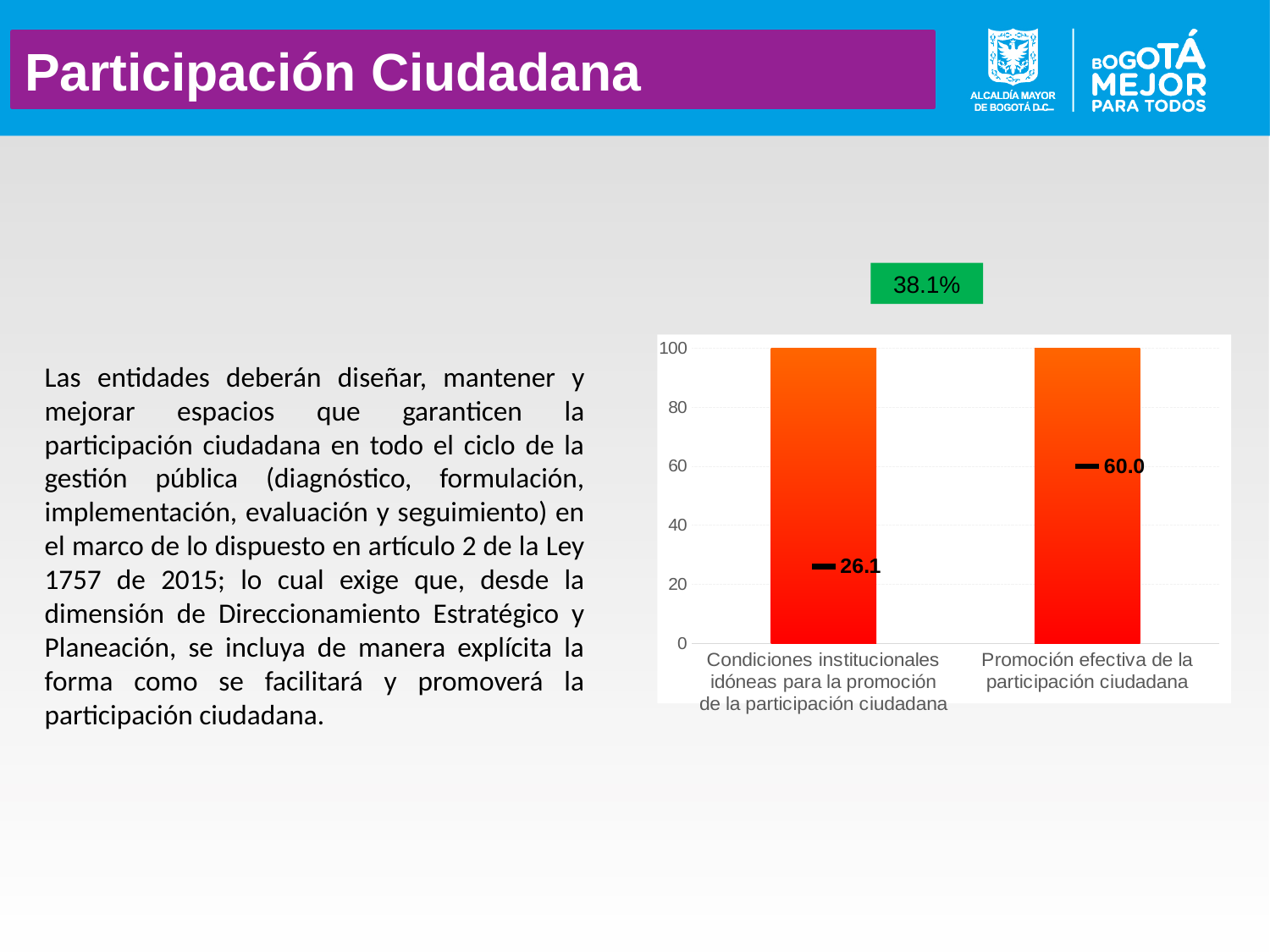
Is the marked value for "Promoción efectiva de la participación ciudadana" larger or smaller than the one for "Condiciones institucionales idóneas para la promoción de la participación ciudadana"? larger What is the difference between the marked values for "Promoción efectiva de la participación ciudadana" and "Condiciones institucionales idóneas para la promoción de la participación ciudadana"? 33.9 How many categories are shown on the x axis of the chart? 2 Which category has the lower marked value? Condiciones institucionales idóneas para la promoción de la participación ciudadana What value is marked for "Condiciones institucionales idóneas para la promoción de la participación ciudadana"? 26.1 What is the highest value shown on the vertical axis of the chart? 100 What kind of chart is shown on the slide? bar chart Is the marked value for "Condiciones institucionales idóneas para la promoción de la participación ciudadana" greater or less than 40? less What percentage is shown in the green box above the chart? 38.1% What value is marked for "Promoción efectiva de la participación ciudadana"? 60.0 Which category has the higher marked value? Promoción efectiva de la participación ciudadana